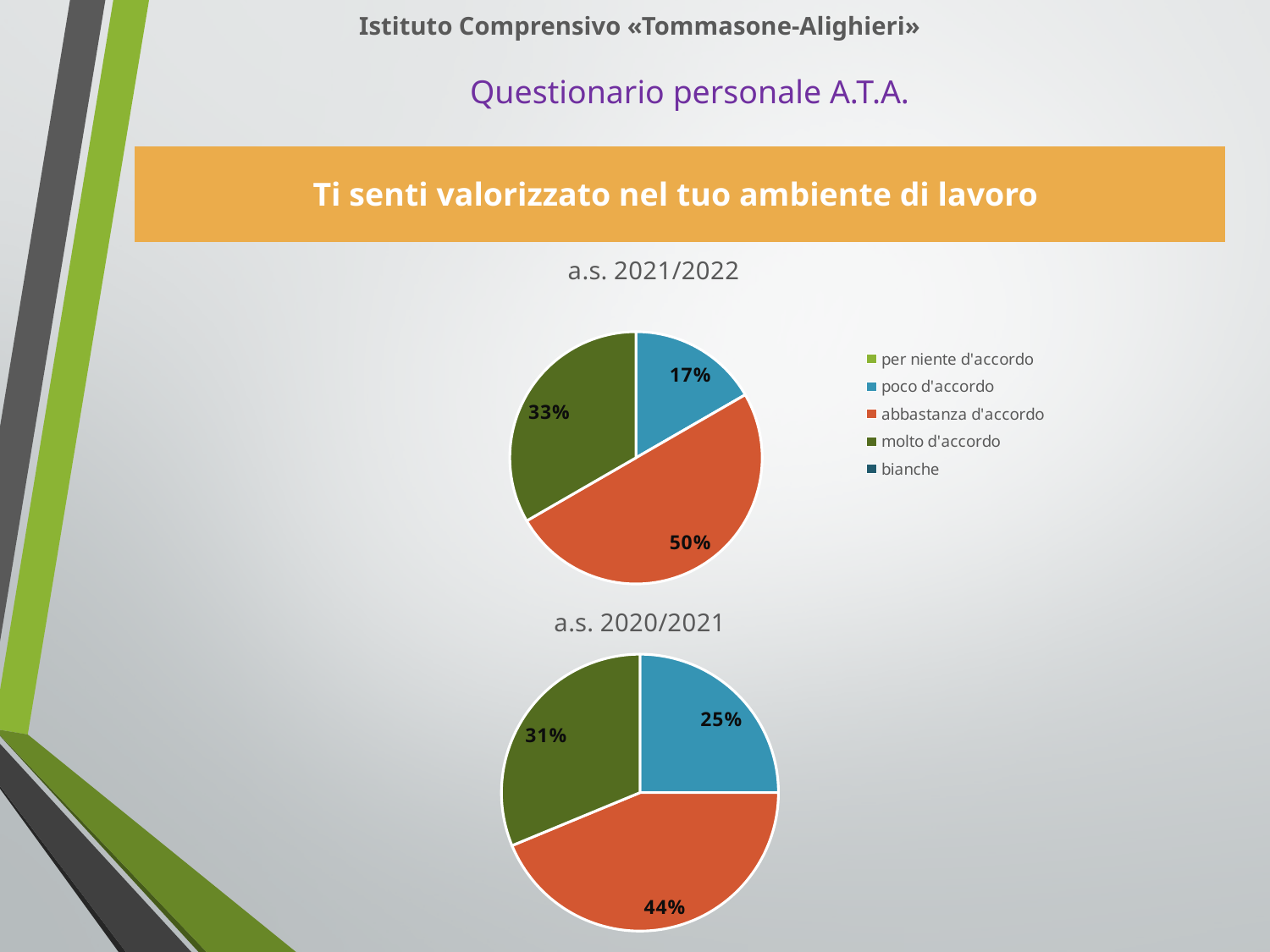
In the 'a.s. 2021/2022' chart, what percentage is shown for 'abbastanza d'accordo'? 50% In the 'a.s. 2021/2022' chart, what is the difference between the 'abbastanza d'accordo' and 'molto d'accordo' percentages? 17% In the 'a.s. 2020/2021' chart, which category has the smallest slice? poco d'accordo Is the 'poco d'accordo' share larger in the 'a.s. 2021/2022' chart or in the 'a.s. 2020/2021' chart? a.s. 2020/2021 In the 'a.s. 2021/2022' chart, which category has the largest slice? abbastanza d'accordo In the 'a.s. 2020/2021' chart, which is larger: 'molto d'accordo' or 'poco d'accordo'? molto d'accordo In the 'a.s. 2020/2021' chart, what percentage is shown for 'abbastanza d'accordo'? 44% In the 'a.s. 2021/2022' chart, what percentage is shown for 'poco d'accordo'? 17% What type of chart is used for 'a.s. 2020/2021'? pie chart In the 'a.s. 2020/2021' chart, what percentage is shown for 'molto d'accordo'? 31% How many slices with data labels are shown in the 'a.s. 2021/2022' chart? 3 How many entries does the legend list? 5